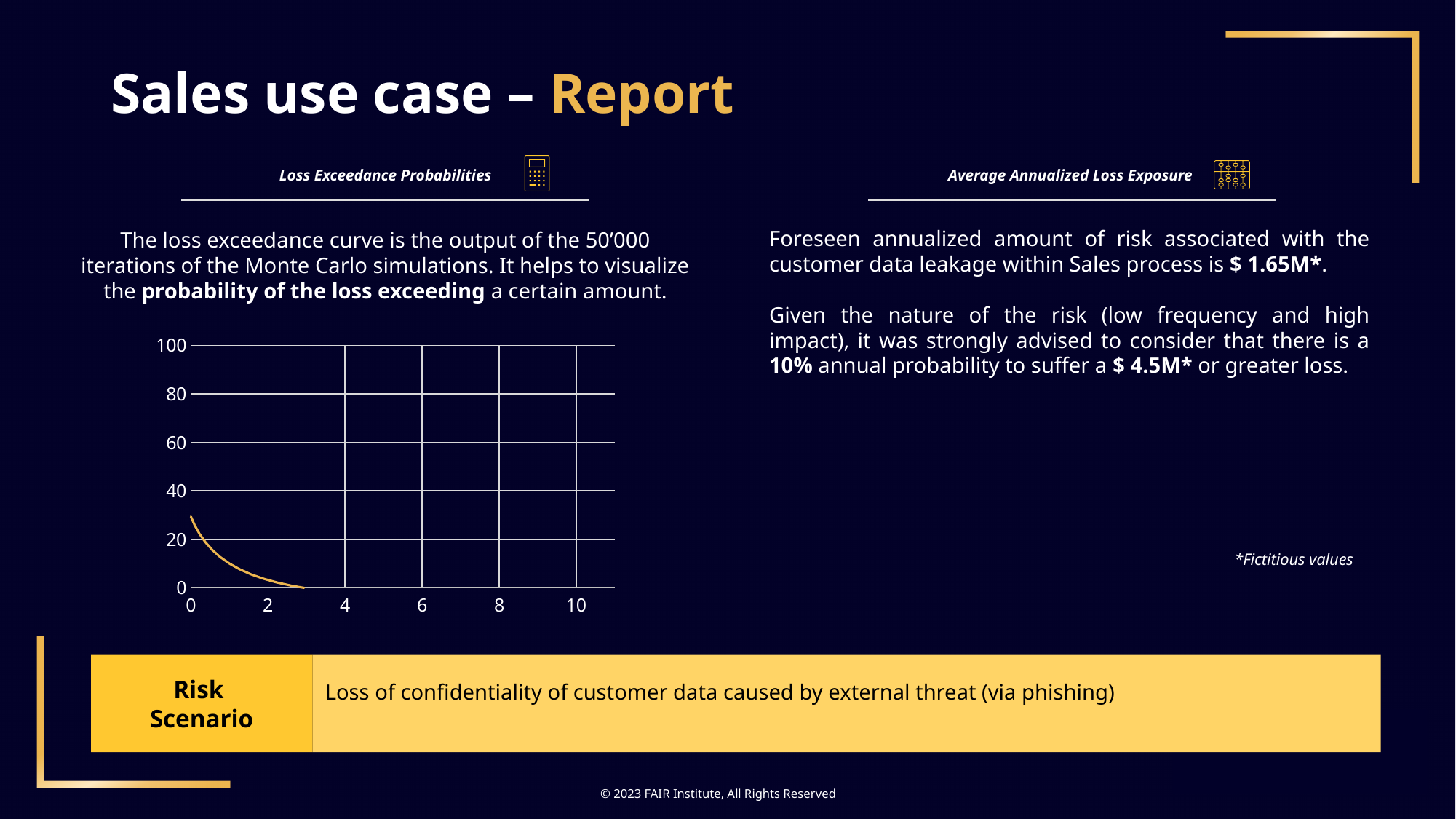
Is the value of the curve at x = 0 greater or less than 40? less Does the plotted curve rise or fall as the x-axis value increases? fall At which x-axis value does the curve reach its highest point? 0 Is the value of the curve at x = 2 greater or less than 20? less What is the highest value labelled on the x-axis of the chart? 10 What is the highest value labelled on the y-axis of the chart? 100 What kind of chart is shown under the Loss Exceedance Probabilities heading? line chart How many lines are plotted on the chart? 1 Is the value of the curve at x = 0 greater or less than 20? greater How many tick labels are shown on the x-axis of the chart? 6